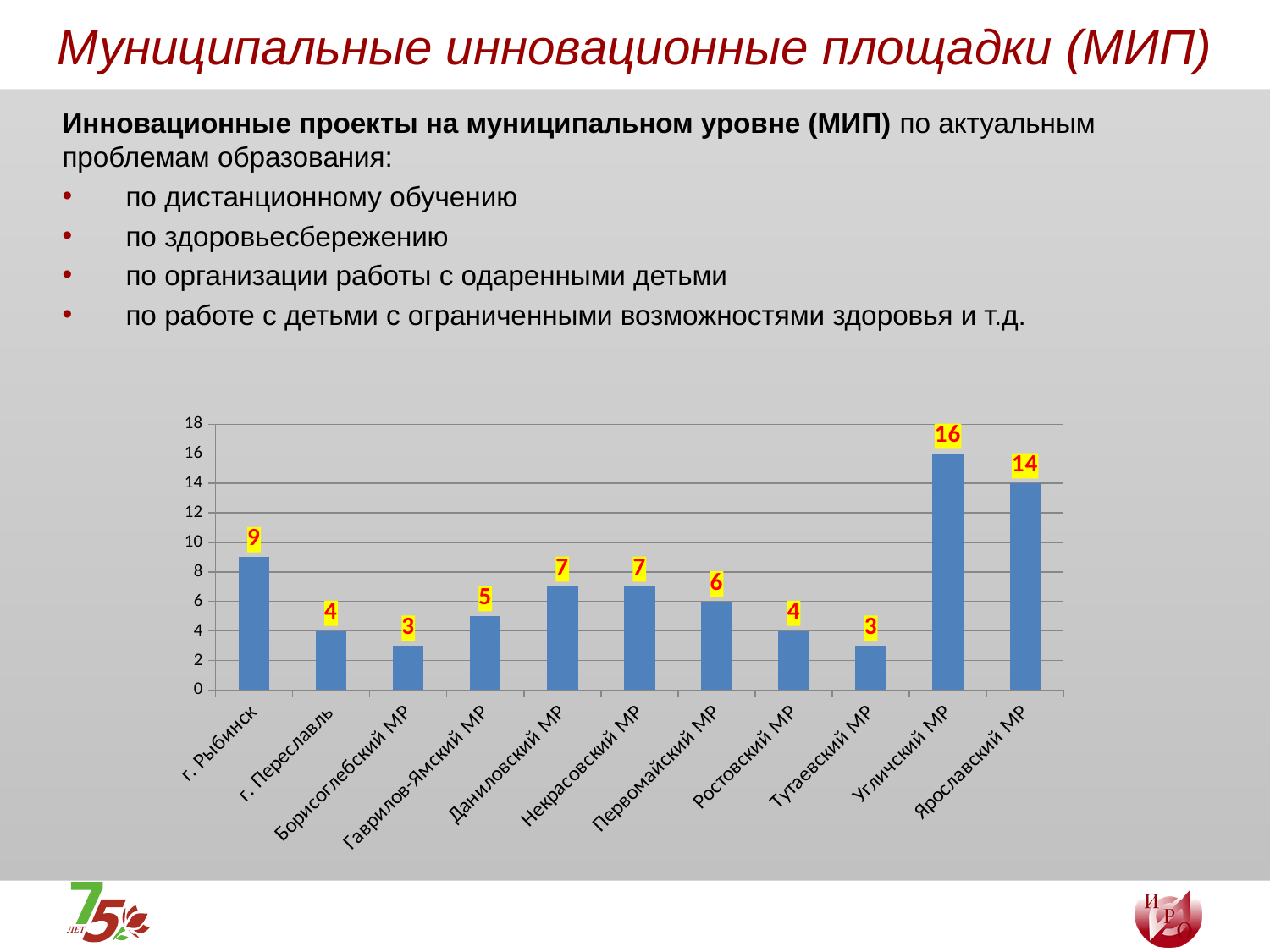
Which category has the highest value? Угличский МР What is the value for г. Рыбинск? 9 Is the value for Ярославский МР greater or less than 12? greater How many categories are shown on the x axis? 11 What is the value for Угличский МР? 16 What kind of chart is shown on the slide? bar chart What is the value for Тутаевский МР? 3 What is the value for Гаврилов-Ямский МР? 5 Which is larger, the value for Первомайский МР or the value for Ростовский МР? Первомайский МР What is the difference between the values for Угличский МР and г. Рыбинск? 7 What is the difference between the values for Ярославский МР and г. Переславль? 10 What colour are the bars in the chart? blue